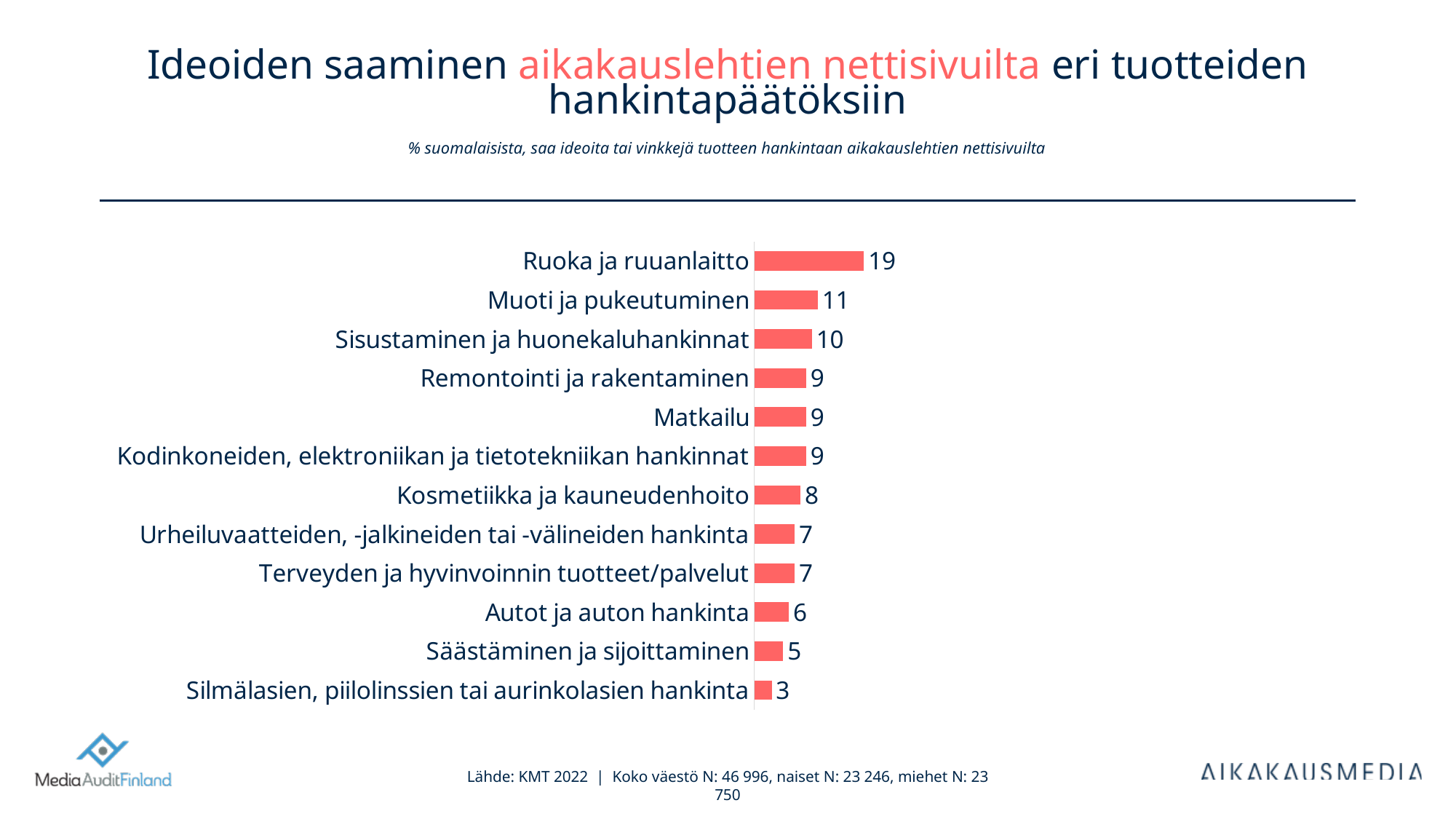
What colour are the bars in the chart? Red What is the difference between the values for Autot ja auton hankinta and Silmälasien, piilolinssien tai aurinkolasien hankinta? 3 Which category has the lowest value? Silmälasien, piilolinssien tai aurinkolasien hankinta What is the value for Ruoka ja ruuanlaitto? 19 Which is larger, the value for Muoti ja pukeutuminen or the value for Sisustaminen ja huonekaluhankinnat? Muoti ja pukeutuminen What is the difference between the values for Ruoka ja ruuanlaitto and Muoti ja pukeutuminen? 8 Which category has the highest value? Ruoka ja ruuanlaitto What is the value for Kosmetiikka ja kauneudenhoito? 8 What kind of chart is shown on the slide? Bar chart What is the value for Säästäminen ja sijoittaminen? 5 How many categories are shown in the chart? 12 How many categories have a value of 9? 3